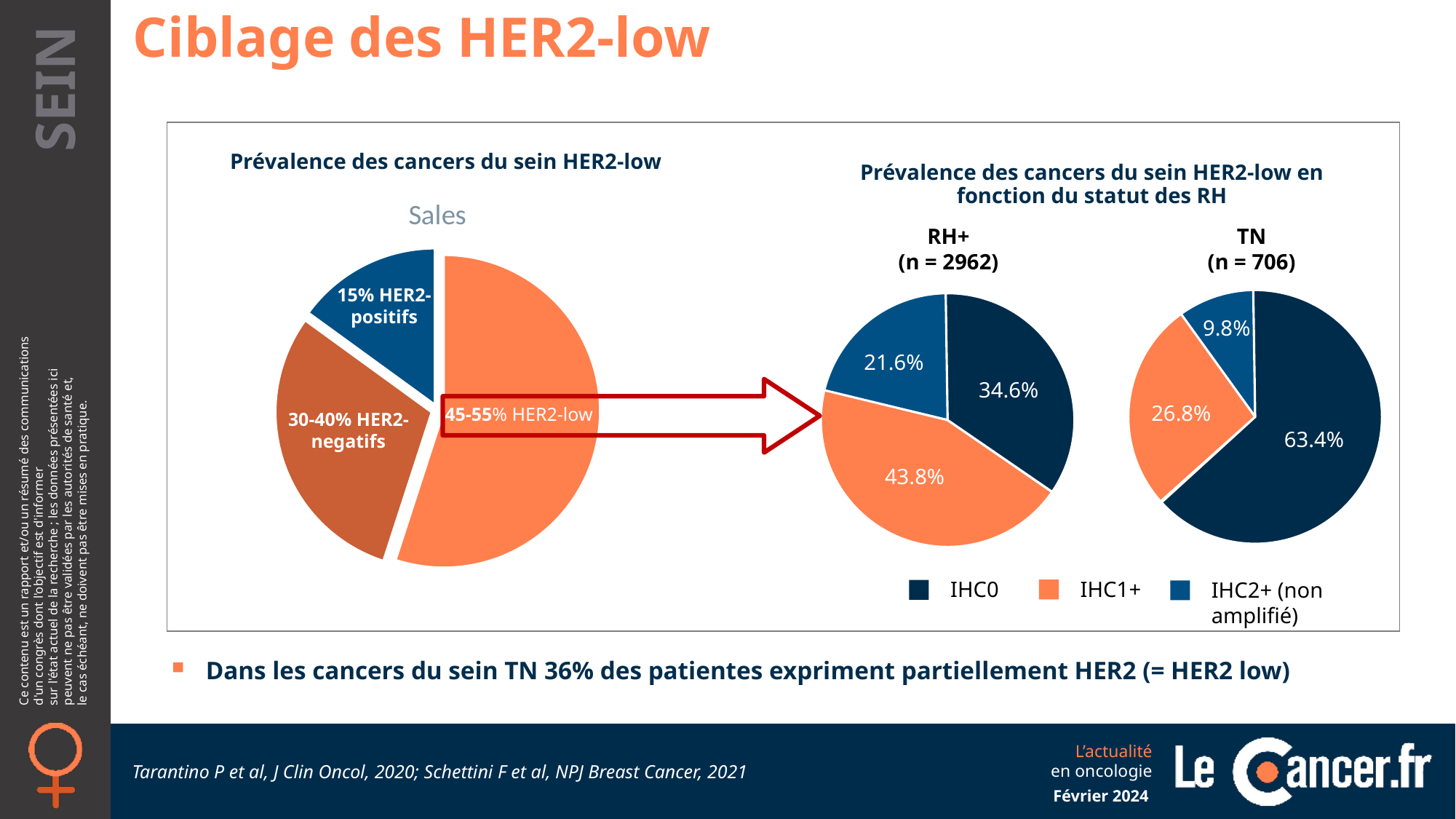
What type of chart is used for the RH+ (n = 2962) data? Pie chart In the TN (n = 706) pie chart, which category has the smallest share? IHC2+ (non amplifié) In the RH+ (n = 2962) pie chart, what share is IHC2+ (non amplifié)? 21.6% Which is larger in the TN (n = 706) pie chart: IHC1+ or IHC2+ (non amplifié)? IHC1+ In the left pie chart 'Prévalence des cancers du sein HER2-low', what range is given for HER2-low? 45-55% In the left pie chart 'Prévalence des cancers du sein HER2-low', what share is labelled for HER2-positifs? 15% In the RH+ (n = 2962) pie chart, what share is IHC1+? 43.8% How many series does the legend of the RH+/TN pie charts list? 3 In the RH+ (n = 2962) pie chart, which category has the largest share? IHC1+ In the TN (n = 706) pie chart, what share is IHC2+ (non amplifié)? 9.8% What is the difference between the IHC0 share in the TN pie chart and the IHC0 share in the RH+ pie chart? 28.8% In the TN (n = 706) pie chart, what share is IHC0? 63.4%